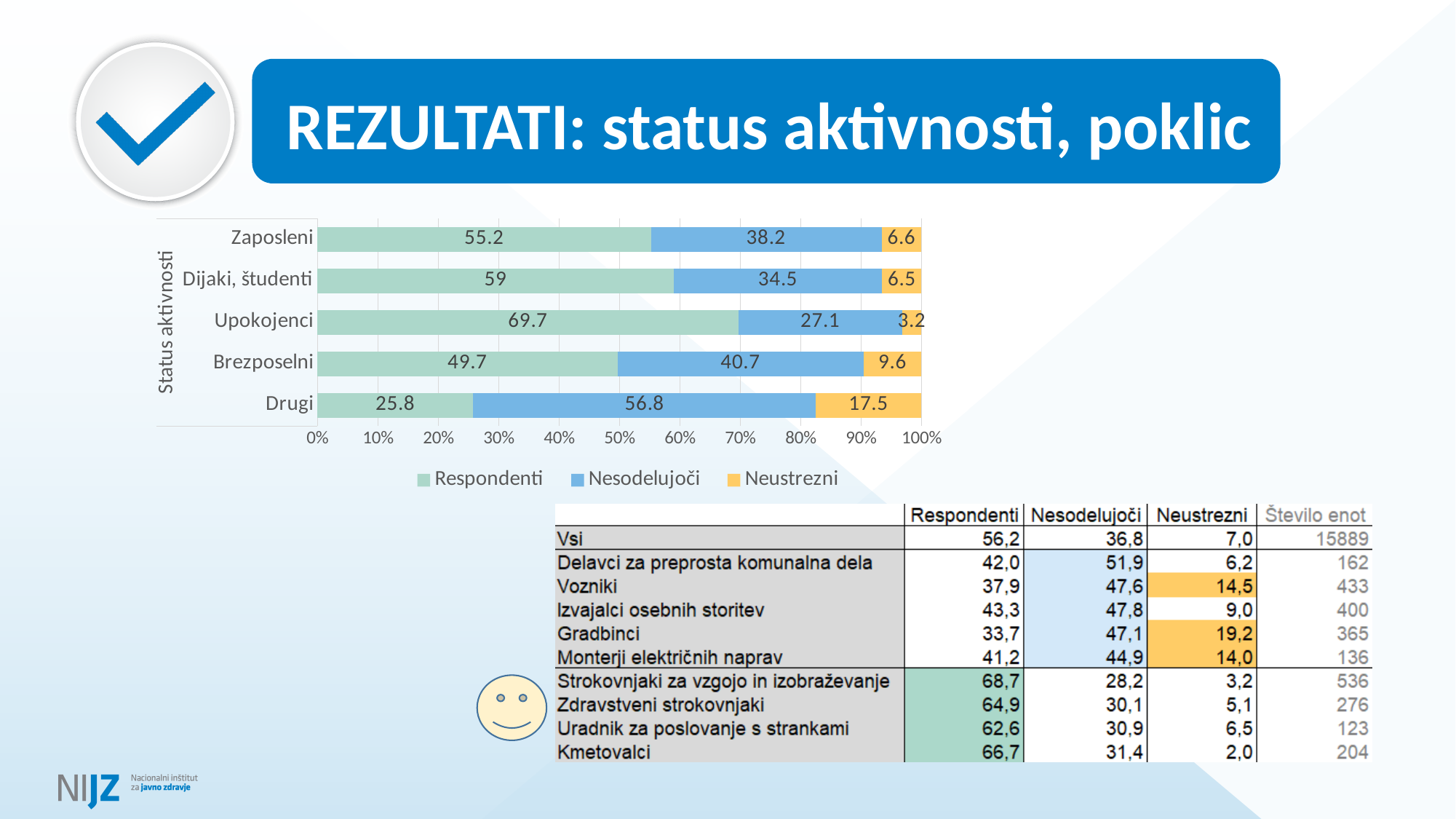
Which category has the lowest Respondenti value? Drugi What is the difference between the Nesodelujoči values for Drugi and Zaposleni? 18.6 Which category has the highest Neustrezni value? Drugi What kind of chart is shown on the slide? Stacked bar chart How many categories are shown on the chart? 5 What is the Respondenti value for Upokojenci? 69.7 What is the title of the vertical axis of the chart? Status aktivnosti Which has the larger Neustrezni value, Brezposelni or Zaposleni? Brezposelni What is the Neustrezni value for Drugi? 17.5 What is the Nesodelujoči value for Dijaki, študenti? 34.5 Which category has the highest Respondenti value? Upokojenci How many series does the legend list? 3